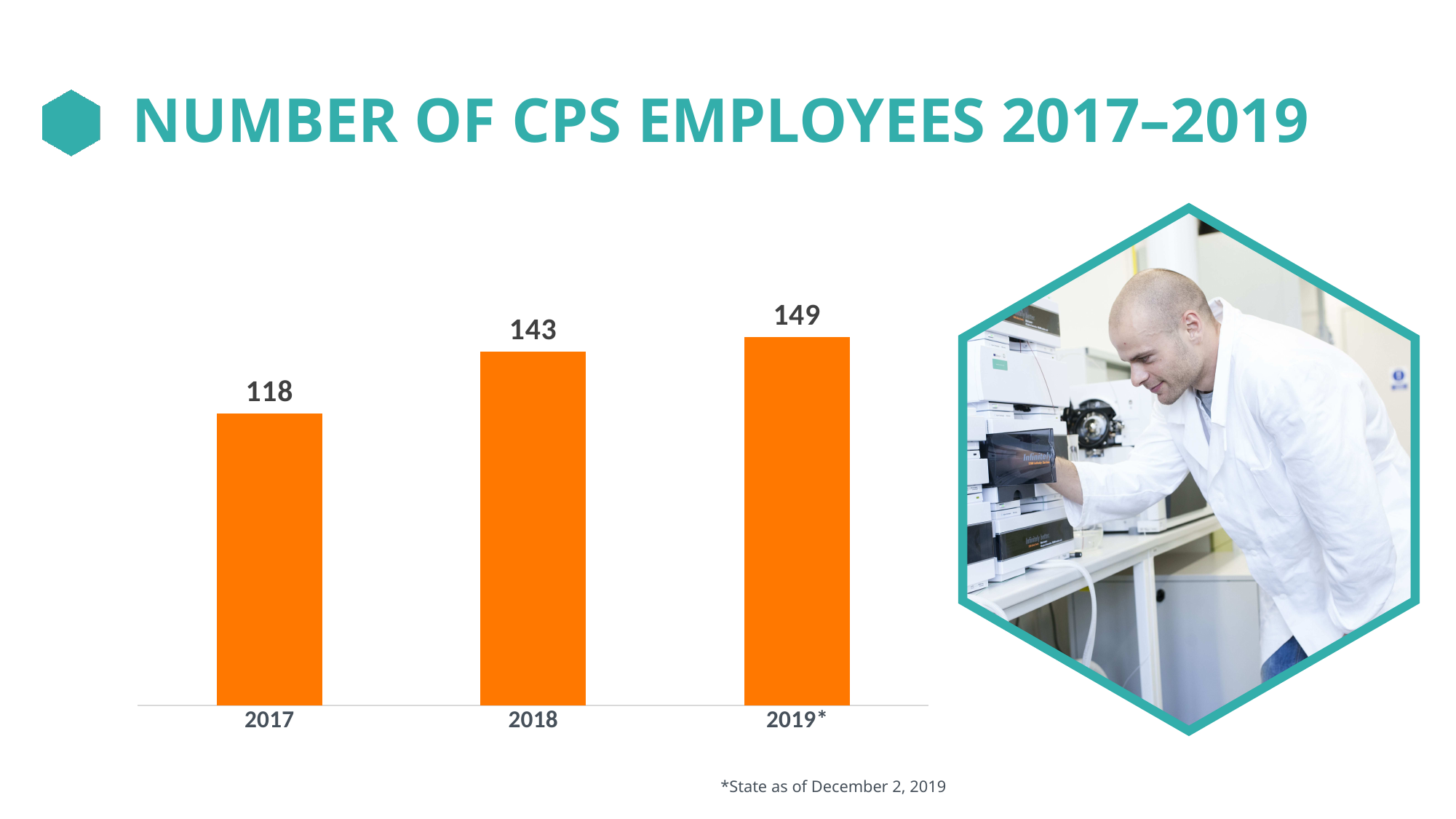
By how much did the number of CPS employees increase from 2017 to 2018? 25 Which year has the lowest number of CPS employees? 2017 What is the difference in the number of CPS employees between 2018 and 2019*? 6 Which year had more CPS employees, 2017 or 2018? 2018 Does the number of CPS employees rise or fall from 2017 to 2019? Rise How many CPS employees were there in 2017? 118 What is the number of CPS employees shown for 2019*? 149 Which year has the highest number of CPS employees? 2019* What type of chart is used to show the number of CPS employees? Bar chart How many CPS employees were there in 2018? 143 How many years are shown on the chart? 3 What is the difference in the number of CPS employees between 2017 and 2019*? 31